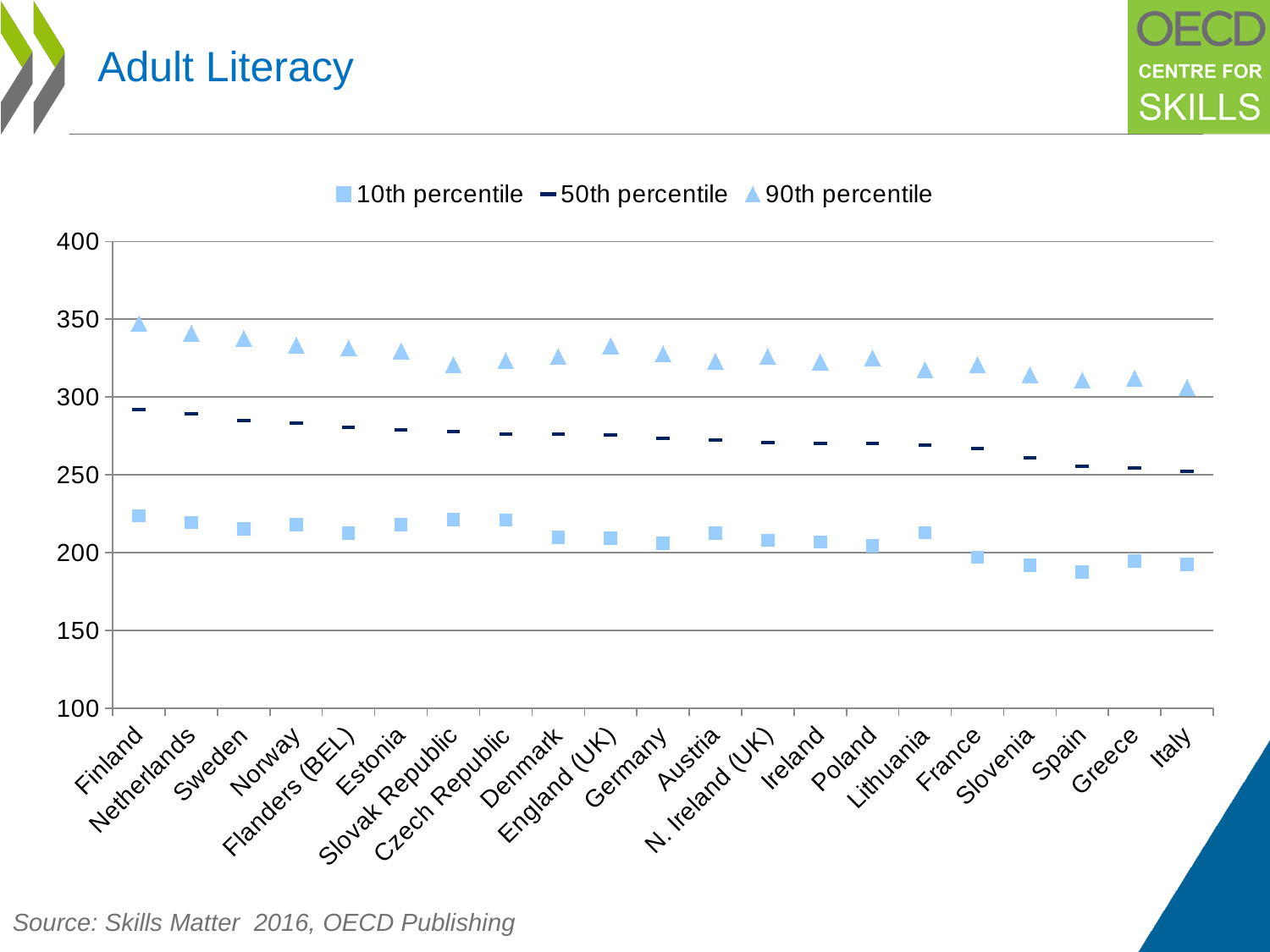
Do the 50th percentile values rise or fall from left to right along the x axis? fall Which country has the highest 90th percentile value? Finland Which country has the lowest 10th percentile value? Spain Which country has the lowest 50th percentile value? Italy Is the 10th percentile value for Spain greater or less than 200? less What kind of chart is shown on the slide? scatter chart Which is larger, the 50th percentile value for Sweden or for Italy? Sweden Is the 50th percentile value for Finland greater or less than 300? less How many series does the legend list? 3 Which country has the lowest 90th percentile value? Italy Is the 90th percentile value for Finland greater or less than 300? greater How many countries are plotted along the x axis? 21